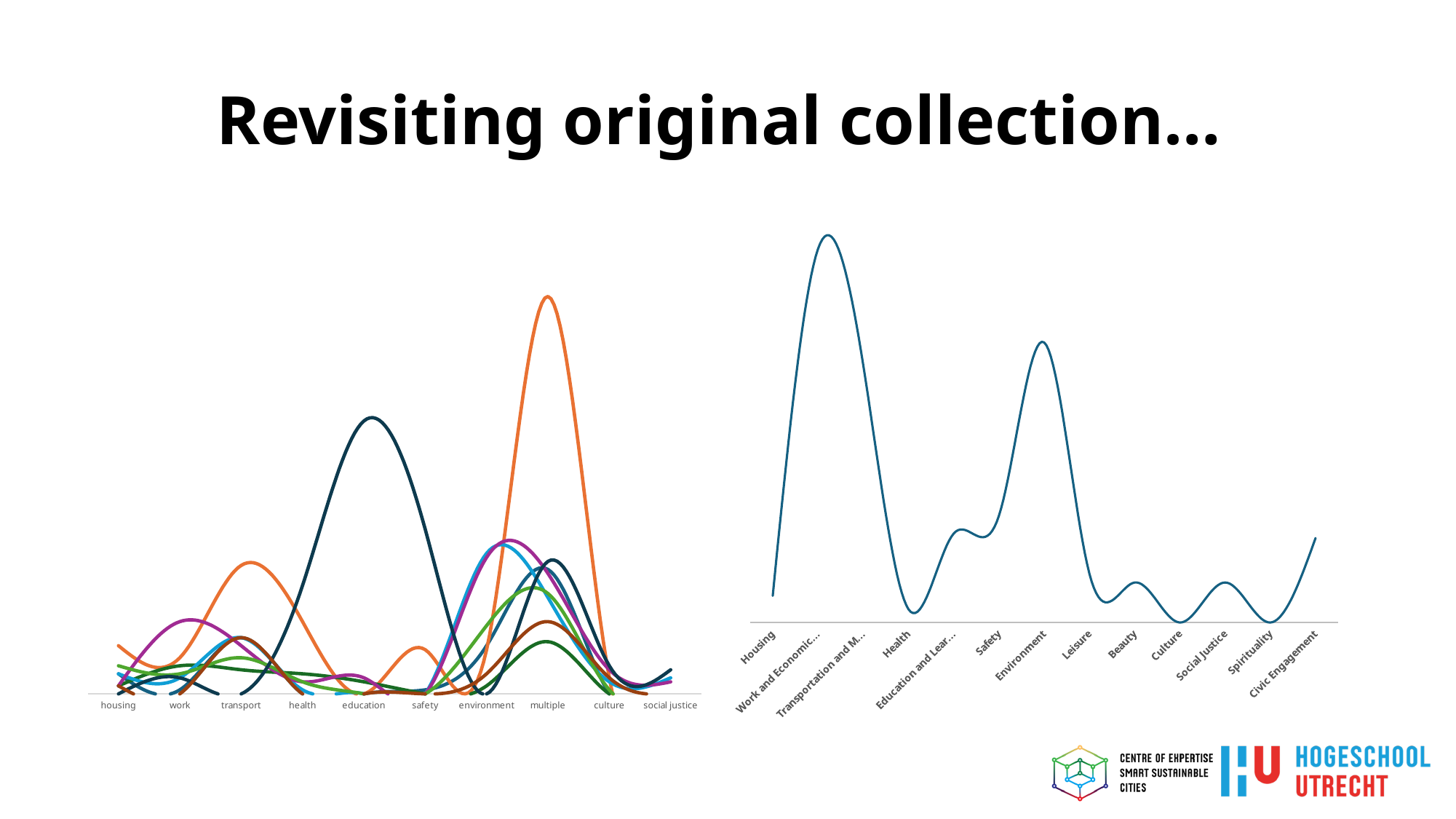
In the right chart, do the values rise or fall from Spirituality to Civic Engagement? rise In the right chart, which is higher, Safety or Environment? Environment In the right chart, which is higher, Environment or Leisure? Environment In the left chart, at which category does the dark navy line reach its highest peak? education In the right chart, which is higher, Housing or Health? Housing What kind of chart is the chart on the left of the slide? line chart In the right chart, which category has the highest value? Work and Economic... How many categories are shown on the x axis of the left chart? 10 In the right chart, do the values rise or fall from Work and Economic... to Health? fall What kind of chart is the chart on the right of the slide? line chart How many categories are shown on the x axis of the right chart? 13 In the left chart, at which category does the tallest peak of any line occur? multiple